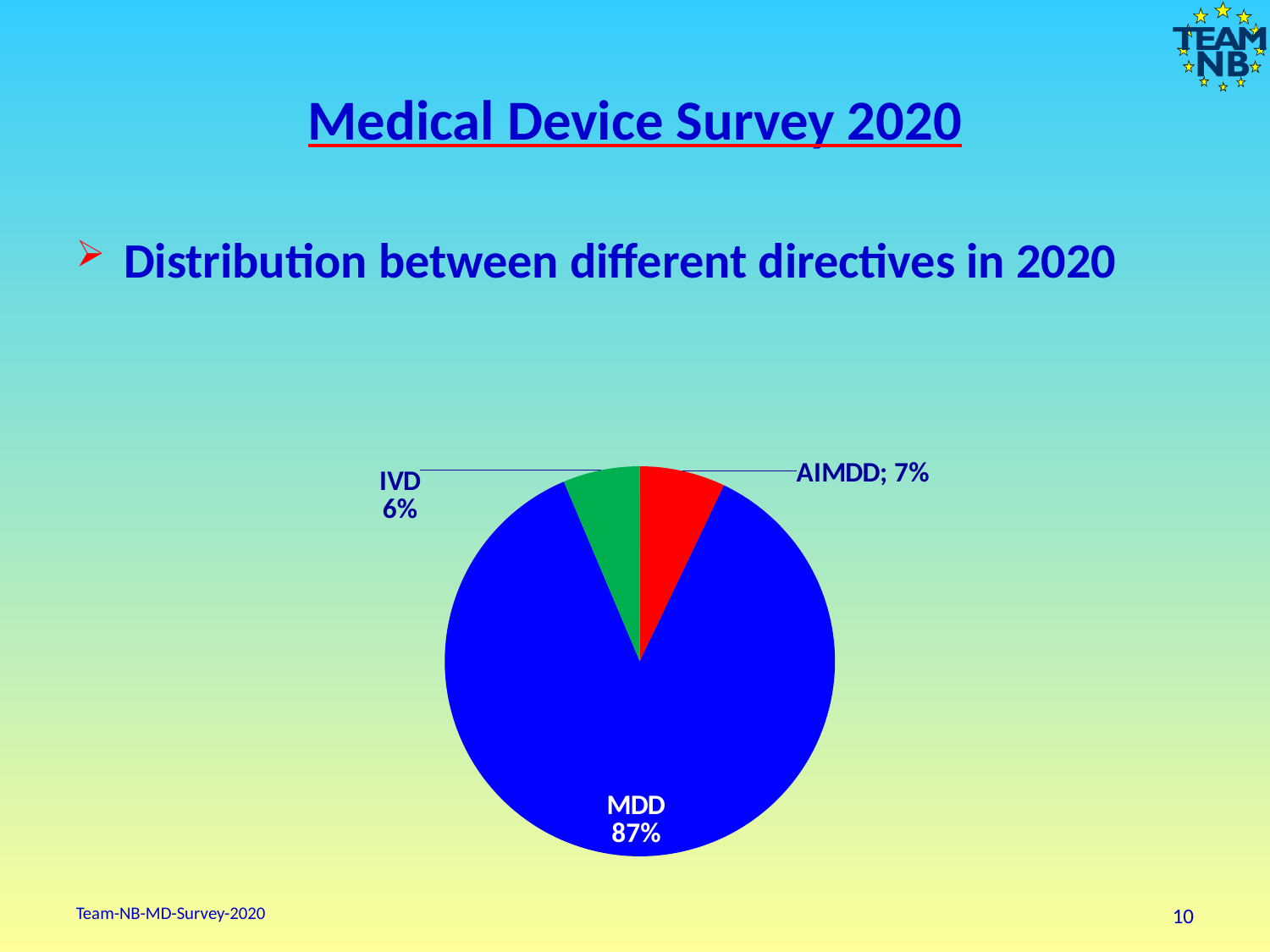
Which directive has the largest slice of the pie? MDD What is the difference in percentage points between the AIMDD and IVD slices? 1 What is the difference in percentage points between the MDD and AIMDD slices? 80 What share of the pie does AIMDD account for? 7% What share of the pie does MDD account for? 87% How many slices does the pie chart have? 3 What colour is the MDD slice of the pie? blue Which slice is larger, MDD or IVD? MDD What kind of chart is shown on the slide? pie chart What share of the pie does IVD account for? 6% Which directive has the smallest slice of the pie? IVD What colour is the IVD slice of the pie? green